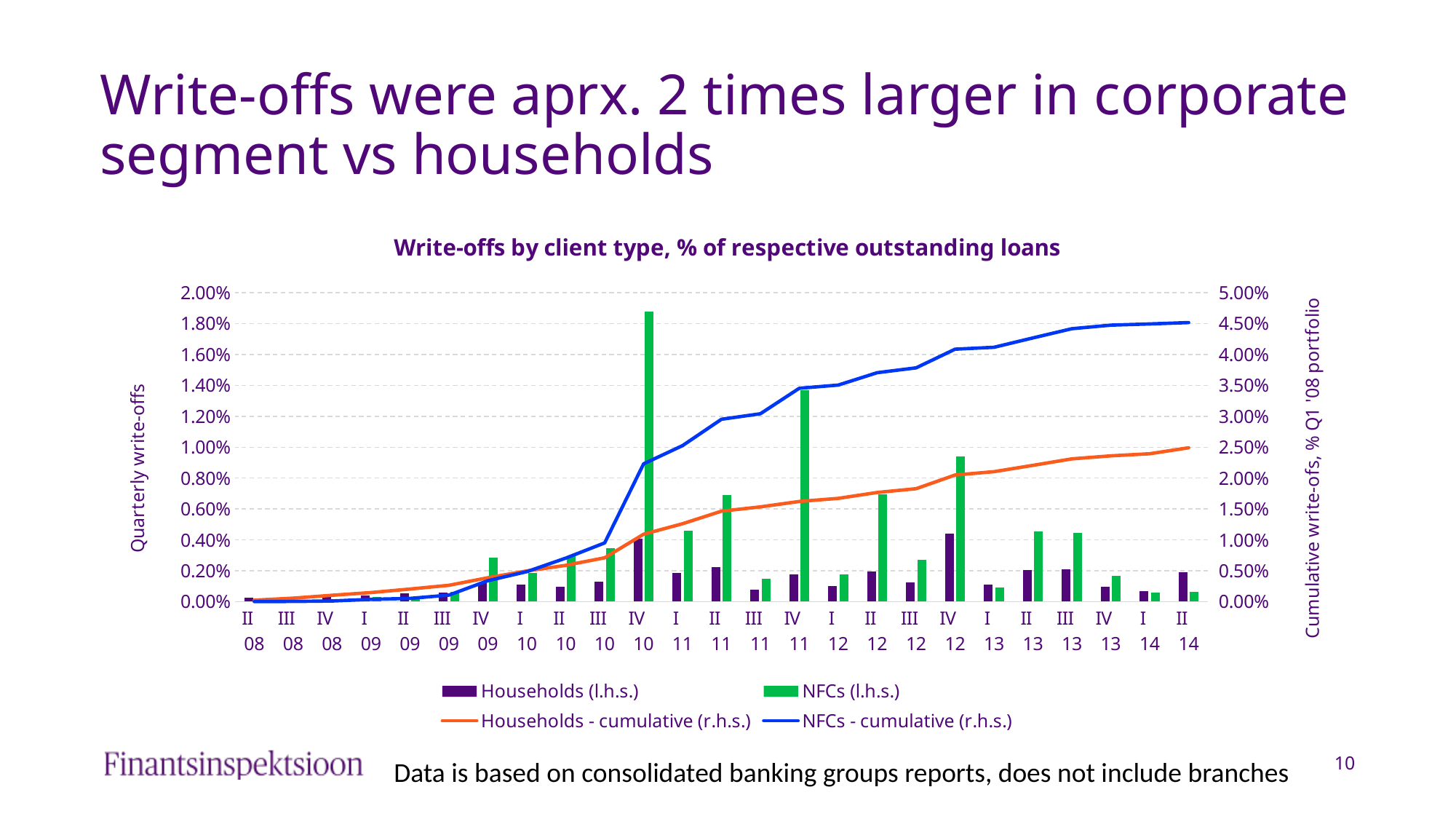
What kind of chart is this? Combined bar and line chart What is the label of the left vertical axis? Quarterly write-offs How many series does the chart legend list? 4 Does the NFCs - cumulative (r.h.s.) line rise or fall from II 08 to II 14? rise How many quarters are shown on the x axis? 25 Is the Households - cumulative (r.h.s.) value for II 14 greater or less than 2.00%? greater Is the NFCs (l.h.s.) value for IV 10 greater or less than 1.60%? greater In which quarter is the NFCs (l.h.s.) bar the highest? IV 10 Which is larger in IV 11, the Households (l.h.s.) bar or the NFCs (l.h.s.) bar? NFCs (l.h.s.) What is the title of the chart? Write-offs by client type, % of respective outstanding loans Is the NFCs - cumulative (r.h.s.) value for II 14 greater or less than 4.00%? greater